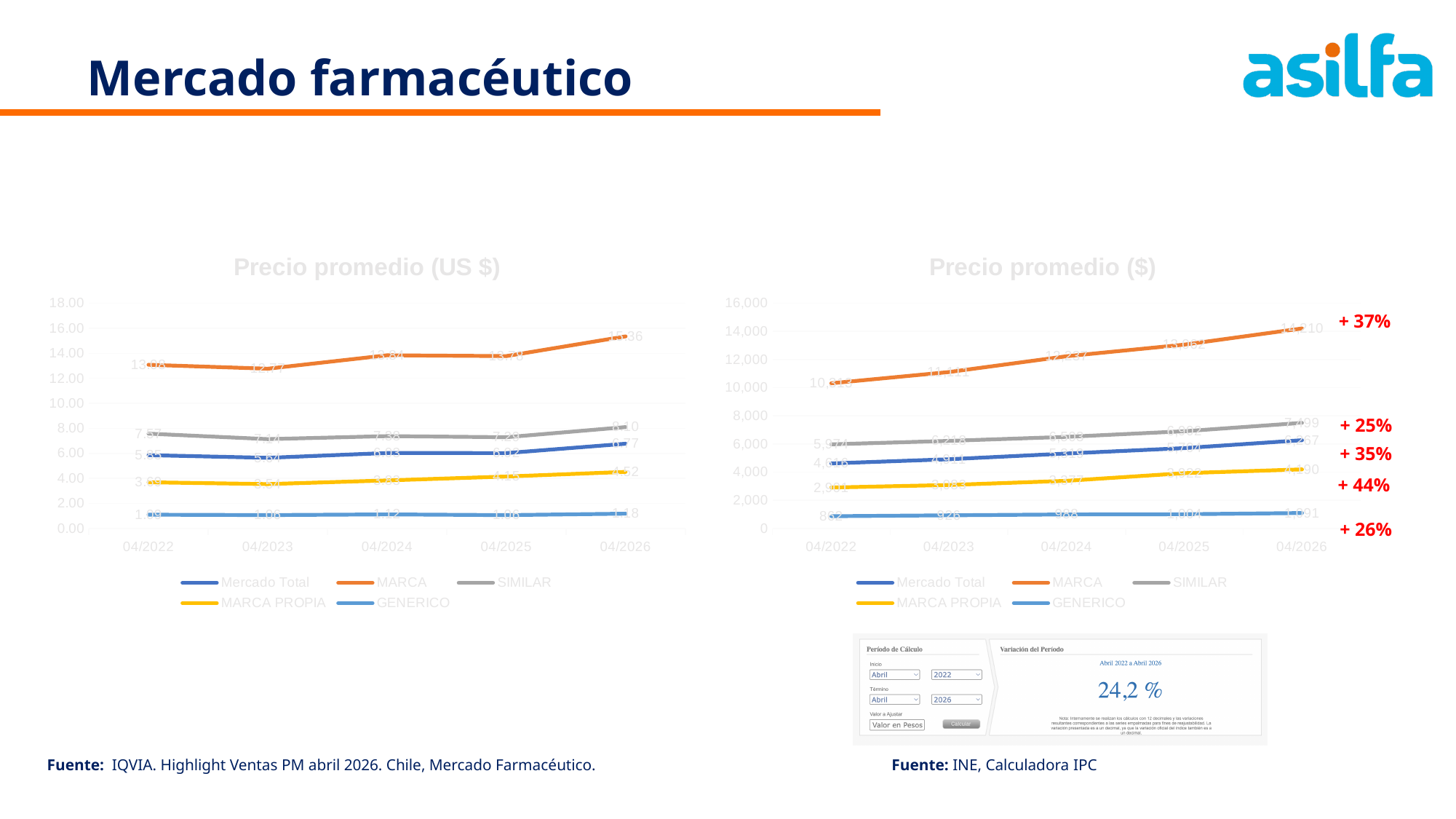
What kind of chart is the "Precio promedio (US $)" chart on the left? line chart In the "Precio promedio ($)" chart, what is the value for MARCA at 04/2024? 12,237 In the "Precio promedio (US $)" chart, what is the value for MARCA at 04/2026? 15.36 In the "Precio promedio (US $)" chart, is the value for MARCA at 04/2026 greater or less than 14.00? greater In the "Precio promedio ($)" chart, is the value for MARCA at 04/2026 greater or less than 12,000? greater How many series does the legend of the "Precio promedio ($)" chart on the right list? 5 In the "Precio promedio (US $)" chart, which series has the highest value at 04/2026? MARCA How many time points are plotted along the x axis of the "Precio promedio (US $)" chart? 5 In the "Precio promedio (US $)" chart, which is larger at 04/2026: SIMILAR or Mercado Total? SIMILAR In the "Precio promedio ($)" chart, which series has the lowest value at 04/2022? GENERICO In the "Precio promedio ($)" chart, what is the value for GENERICO at 04/2022? 862 In the "Precio promedio ($)" chart, does the MARCA series rise or fall from 04/2022 to 04/2026? rise